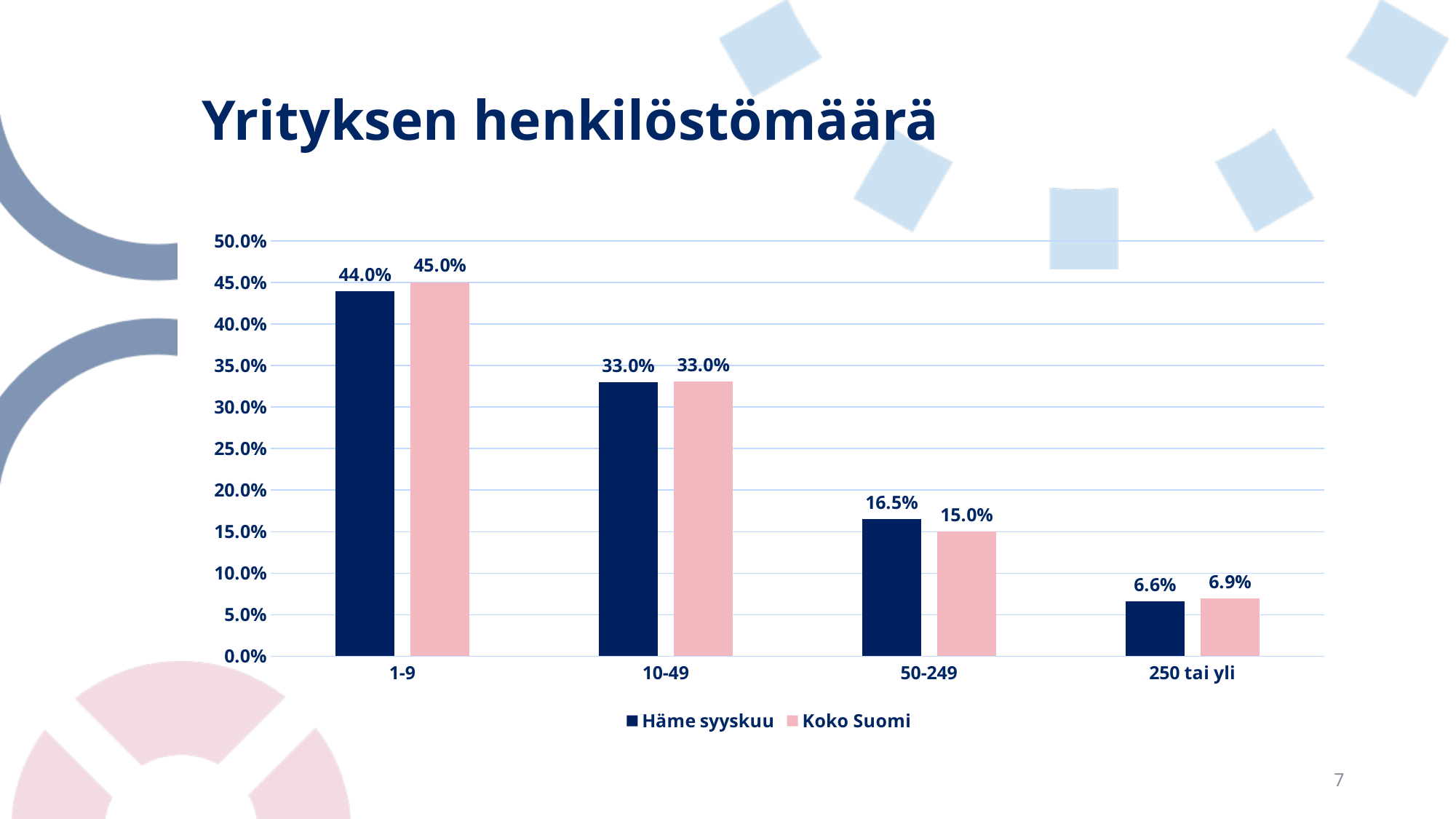
What is the value for Koko Suomi in the 50-249 category? 15.0% What is the difference between Häme syyskuu and Koko Suomi in the 50-249 category? 1.5% What is the value for Koko Suomi in the 250 tai yli category? 6.9% In the 1-9 category, which series has the larger value, Häme syyskuu or Koko Suomi? Koko Suomi What is the value for Häme syyskuu in the 1-9 category? 44.0% Do the Koko Suomi values rise or fall from the 1-9 category to the 250 tai yli category? Fall Which category has the lowest value for Koko Suomi? 250 tai yli Is the value for Häme syyskuu in the 10-49 category greater or less than 30.0%? greater How many series does the legend list? 2 How many categories are shown on the x axis? 4 What kind of chart is shown on the slide? Bar chart Which category has the highest value for Häme syyskuu? 1-9